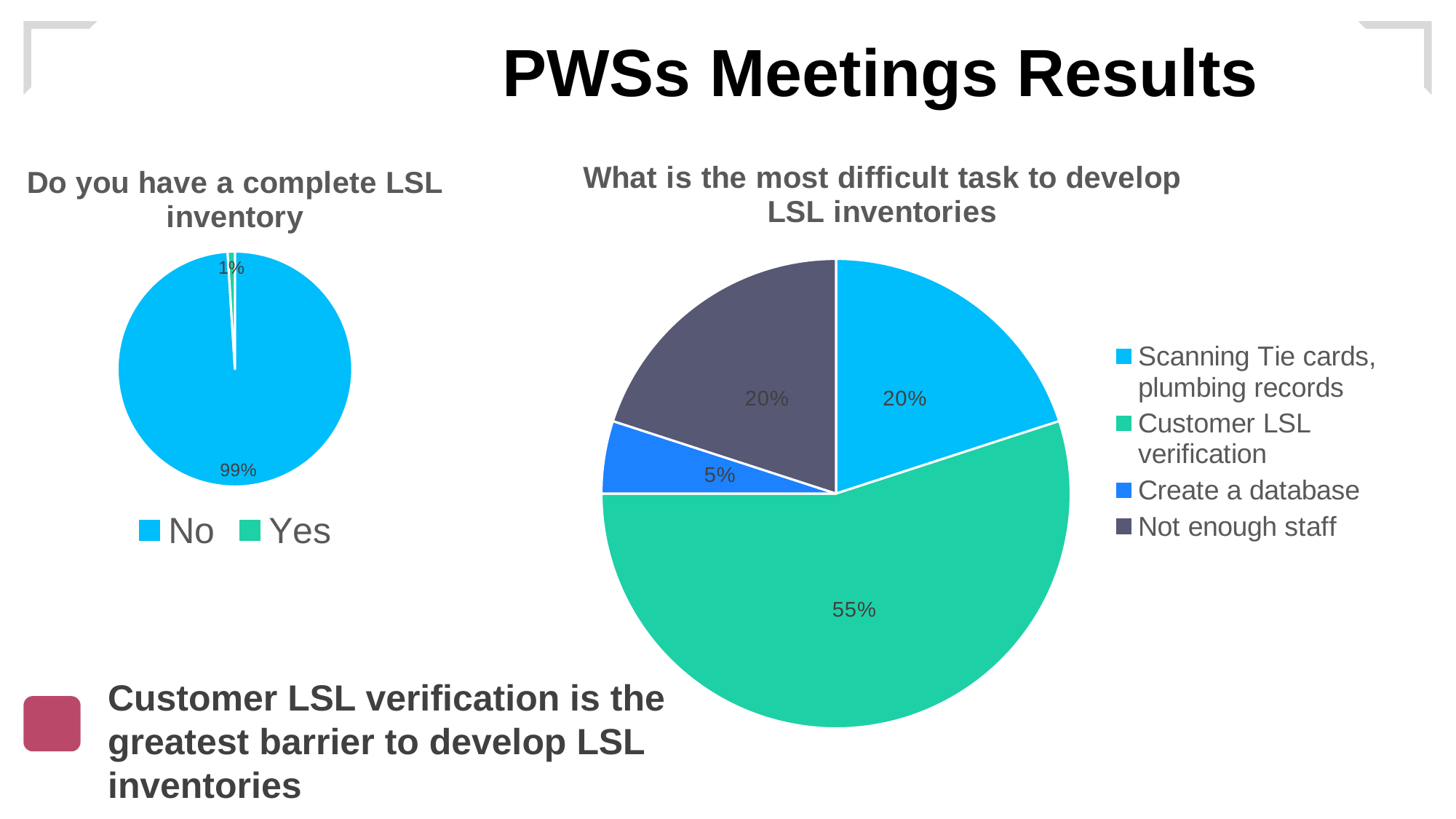
What kind of chart is 'Do you have a complete LSL inventory'? Pie chart In the 'What is the most difficult task to develop LSL inventories' chart, what share is 'Customer LSL verification'? 55% In the 'What is the most difficult task to develop LSL inventories' chart, what is the difference between the shares of 'Customer LSL verification' and 'Not enough staff'? 35% In the 'What is the most difficult task to develop LSL inventories' chart, which category has the largest share? Customer LSL verification In the 'What is the most difficult task to develop LSL inventories' chart, which is larger: 'Scanning Tie cards, plumbing records' or 'Create a database'? Scanning Tie cards, plumbing records In the 'What is the most difficult task to develop LSL inventories' chart, which category has the smallest share? Create a database How many categories does the legend of the 'What is the most difficult task to develop LSL inventories' chart list? 4 In the 'Do you have a complete LSL inventory' chart, what share of responses is 'No'? 99% How many categories does the legend of the 'Do you have a complete LSL inventory' chart list? 2 In the 'Do you have a complete LSL inventory' chart, what share of responses is 'Yes'? 1%